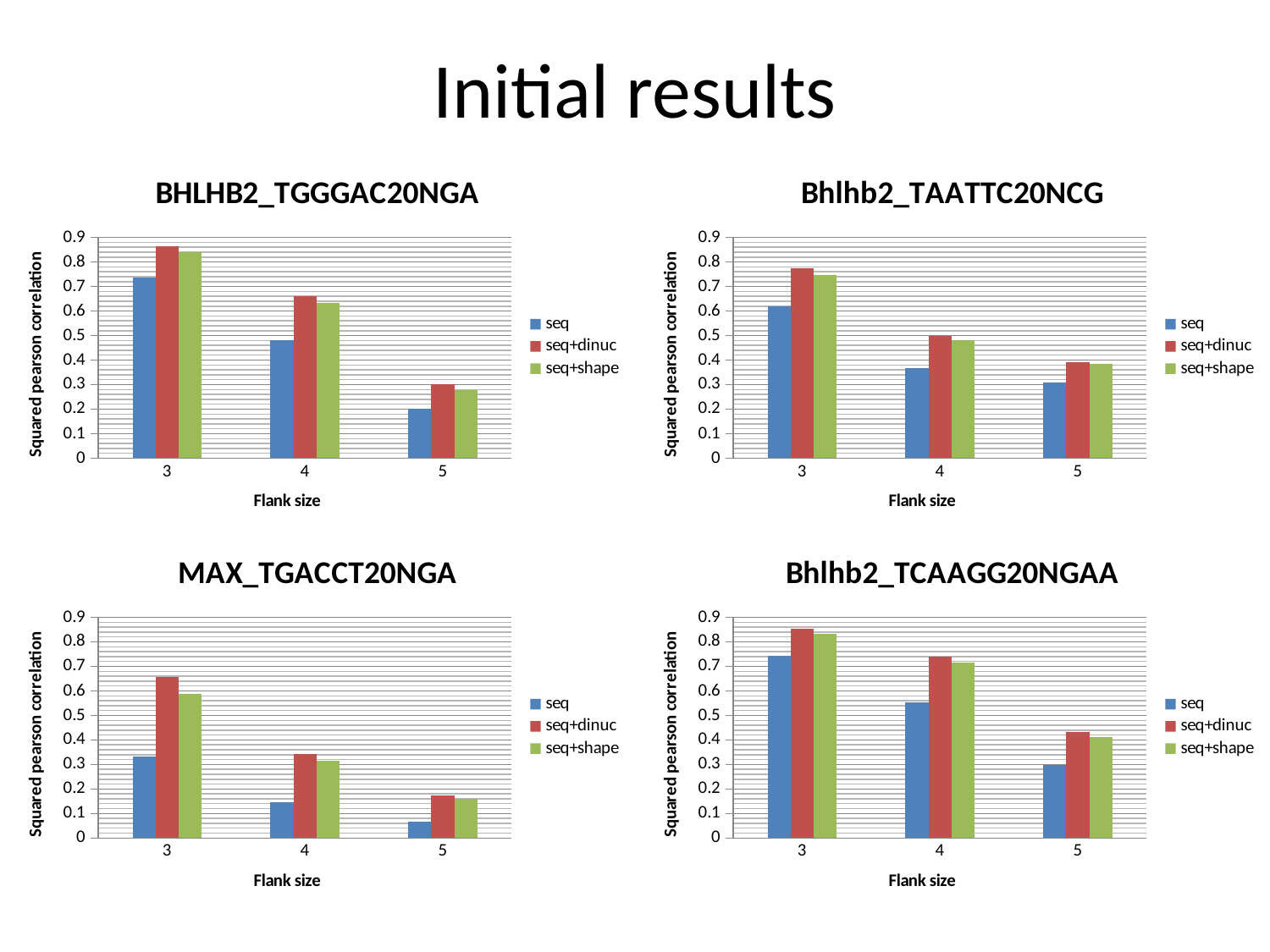
In the Bhlhb2_TCAAGG20NGAA chart, is the value for seq at flank size 4 greater or less than 0.5? greater In the BHLHB2_TGGGAC20NGA chart, is the value for seq at flank size 5 greater or less than 0.3? less In the MAX_TGACCT20NGA chart, which is larger at flank size 3: seq+dinuc or seq+shape? seq+dinuc In the MAX_TGACCT20NGA chart, is the value for seq+dinuc at flank size 3 greater or less than 0.6? greater What kind of chart is the Bhlhb2_TAATTC20NCG chart? Bar chart How many flank size categories are shown on the x axis of the MAX_TGACCT20NGA chart? 3 In the Bhlhb2_TAATTC20NCG chart, which series has the highest value at flank size 3? seq+dinuc In the MAX_TGACCT20NGA chart, which series has the lowest value at flank size 5? seq In the Bhlhb2_TCAAGG20NGAA chart, how do the seq values change as flank size increases from 3 to 5? They fall How many series does the legend of the BHLHB2_TGGGAC20NGA chart list? 3